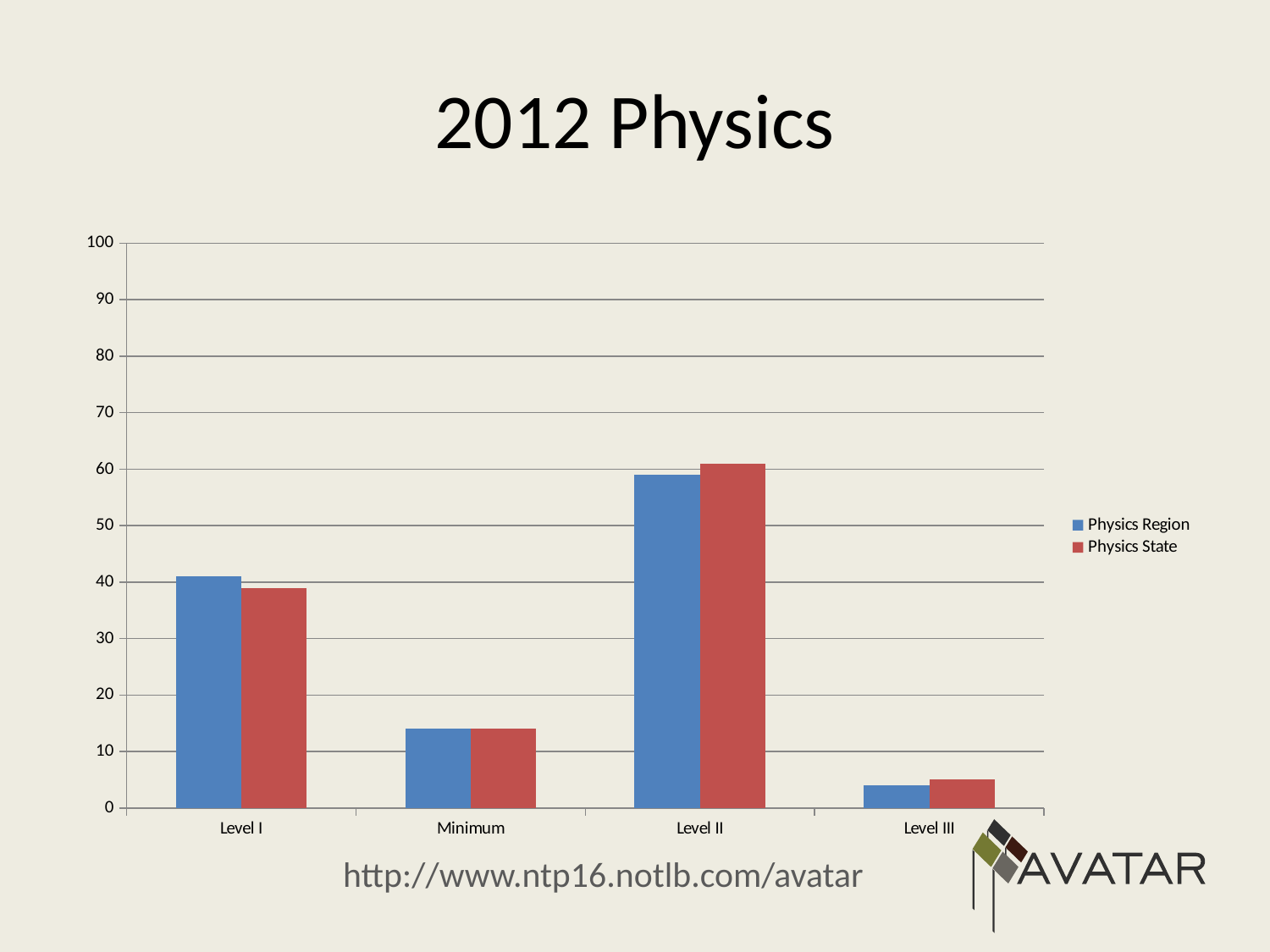
Which category has the lowest value for Physics Region? Level III Is the Physics Region value for Level I greater or less than 30? greater For Physics Region, which is larger: Minimum or Level I? Level I For Physics State, which is larger: Level I or Level II? Level II How many categories are shown on the x axis? 4 How many series does the legend list? 2 What kind of chart is shown on the slide? bar chart What is the title of the slide's chart? 2012 Physics Is the Physics Region value for Minimum greater or less than 20? less Which category has the lowest value for Physics State? Level III Which category has the highest value for Physics Region? Level II Is the Physics State value for Level II greater or less than 50? greater